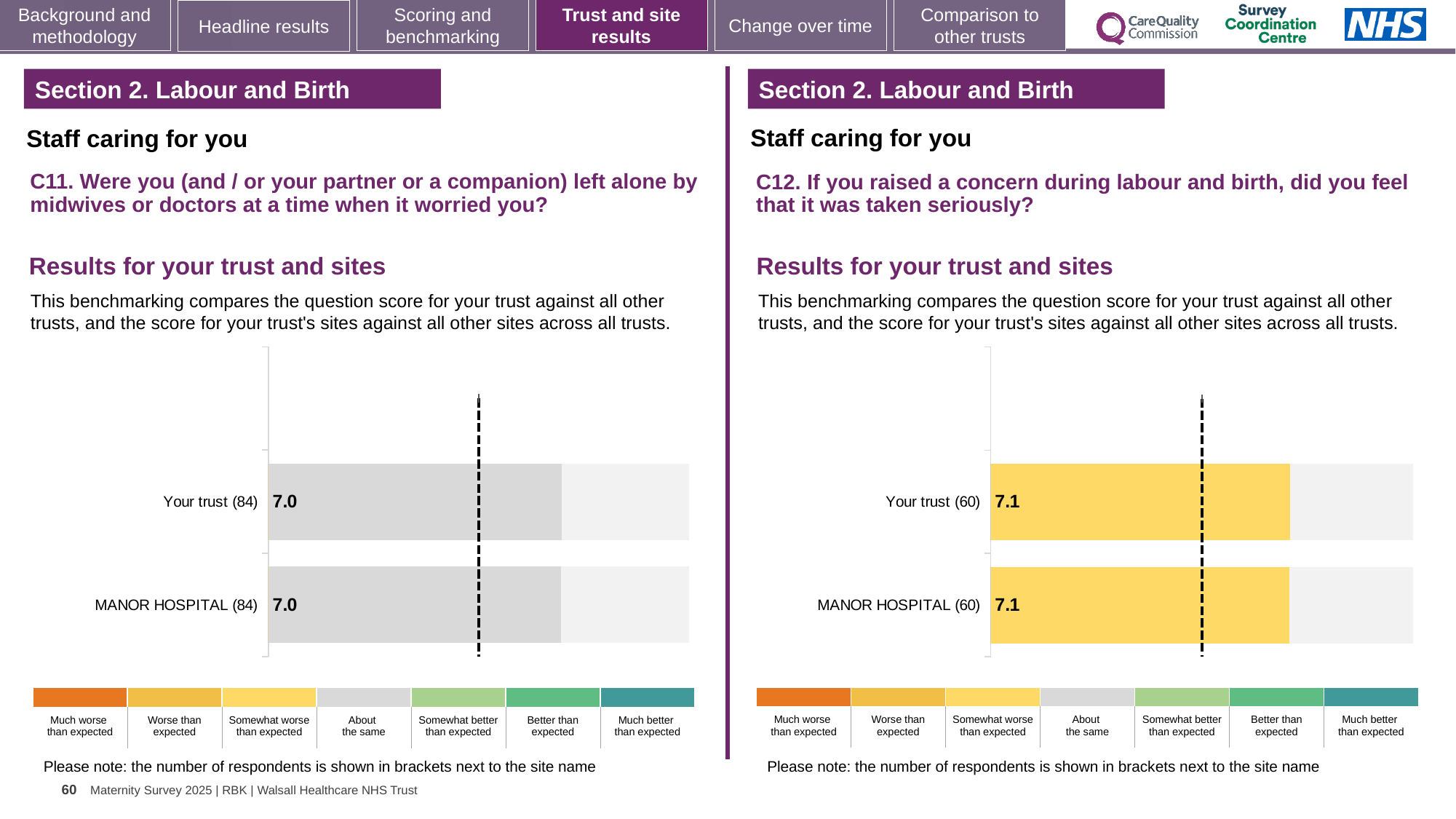
In the C11 chart on the left, how many respondents are shown in brackets next to Your trust? 84 According to the colour key, which benchmark category do the yellow bars in the C12 chart on the right represent? Somewhat worse than expected How many bars are plotted in the C11 chart on the left? 2 In the C11 chart on the left, what is the score for MANOR HOSPITAL? 7.0 In the C12 chart on the right, what is the difference between the Your trust score and the MANOR HOSPITAL score? 0.0 How many bars are plotted in the C12 chart on the right? 2 In the C12 chart on the right, how many respondents are shown in brackets next to MANOR HOSPITAL? 60 In the C11 chart on the left, what is the score for Your trust? 7.0 In the C11 chart on the left, what is the difference between the Your trust score and the MANOR HOSPITAL score? 0.0 In the C12 chart on the right, what is the score for MANOR HOSPITAL? 7.1 What kind of chart is used for the C11 results on the left? Bar chart In the C12 chart on the right, what is the score for Your trust? 7.1